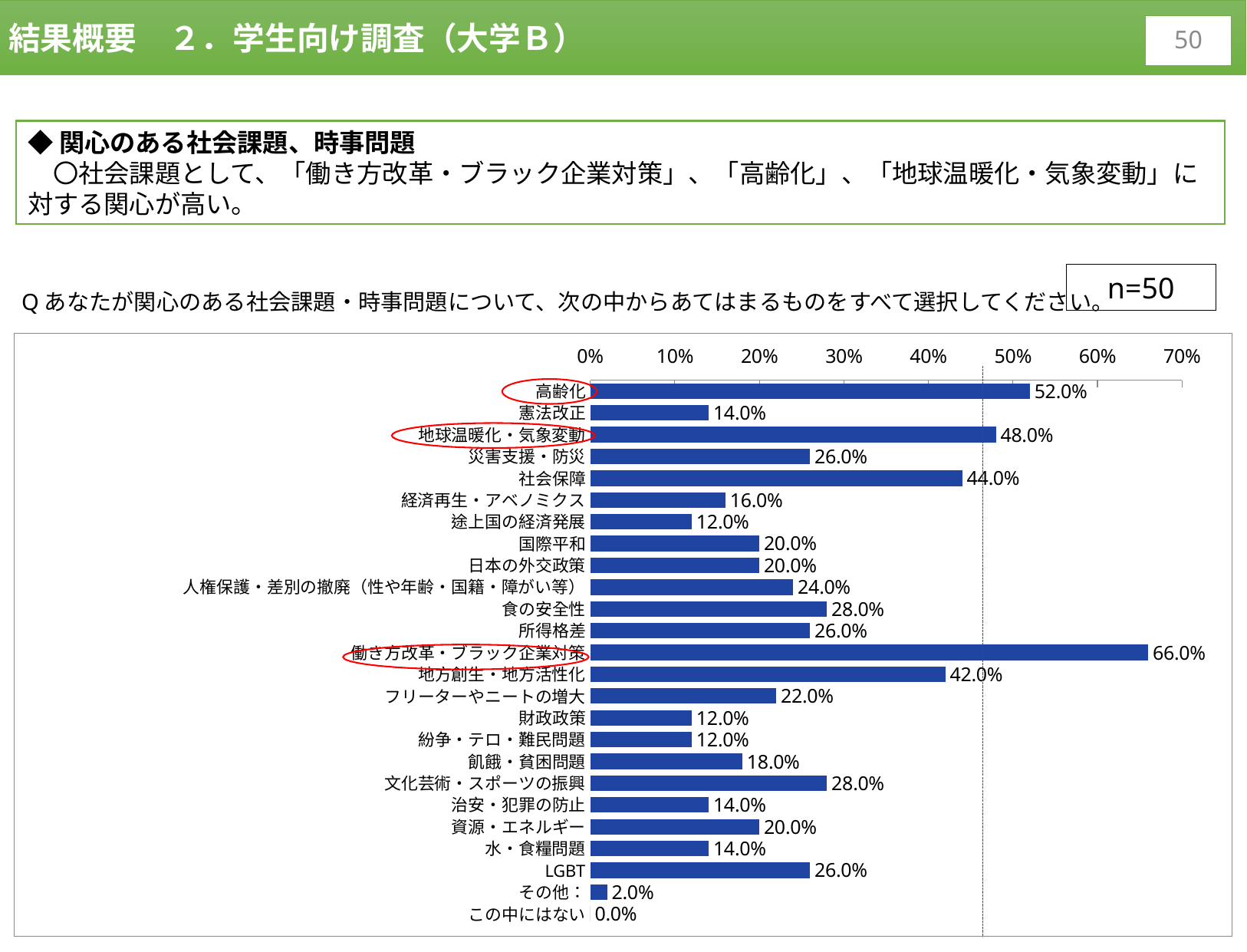
What is the value for 地球温暖化・気象変動? 48.0% What is the value for 高齢化? 52.0% How many categories are shown in the chart? 25 What is the value for LGBT? 26.0% What is the value for 社会保障? 44.0% Which is larger, the value for 地方創生・地方活性化 or the value for 社会保障? 社会保障 What kind of chart is shown on the slide? bar chart Which category has the lowest value? この中にはない What is the difference between the values for 働き方改革・ブラック企業対策 and 高齢化? 14.0% Is the value for 食の安全性 greater or less than 20%? greater What is the sample size (n) shown next to the question text? n=50 Which category has the highest value? 働き方改革・ブラック企業対策